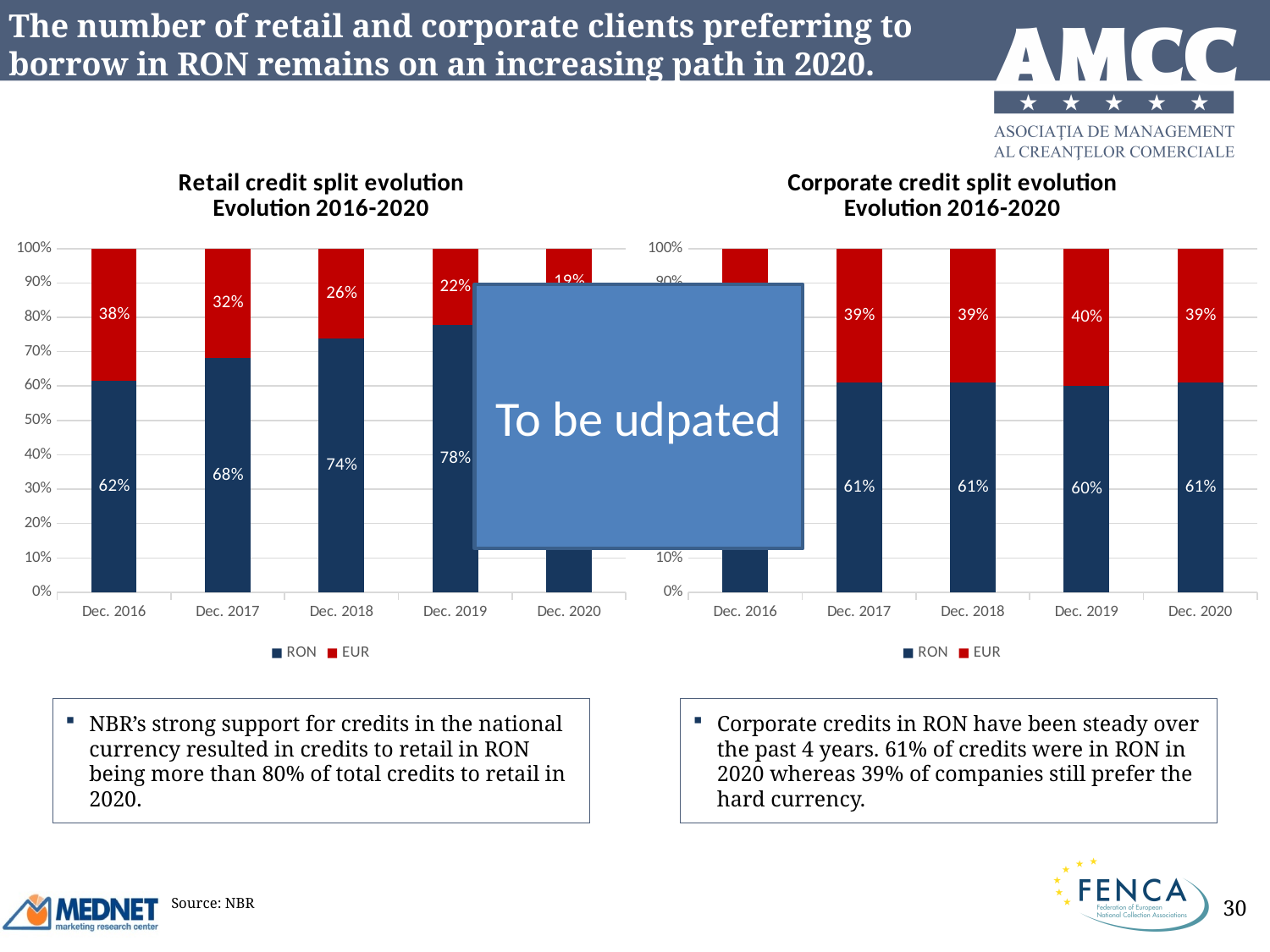
In the Corporate credit split evolution chart, what is the EUR share for Dec. 2020? 39% How many time periods are shown on the x axis of the Retail credit split evolution chart? 5 How many series does the legend of the Corporate credit split evolution chart list? 2 In the Retail credit split evolution chart, what is the EUR share for Dec. 2018? 26% What type of chart is the Corporate credit split evolution chart? stacked bar chart In the Retail credit split evolution chart, what is the total of the RON and EUR shares for Dec. 2018? 100% In the Retail credit split evolution chart, what is the RON share for Dec. 2016? 62% In the Corporate credit split evolution chart, what is the RON share for Dec. 2019? 60% In the Retail credit split evolution chart, does the RON share rise or fall from Dec. 2016 to Dec. 2019? rise In the Retail credit split evolution chart, which is larger for Dec. 2017: the RON share or the EUR share? RON In the Retail credit split evolution chart, what is the RON share for Dec. 2019? 78% In the Retail credit split evolution chart, by how many percentage points did the RON share increase from Dec. 2016 to Dec. 2019? 16 percentage points